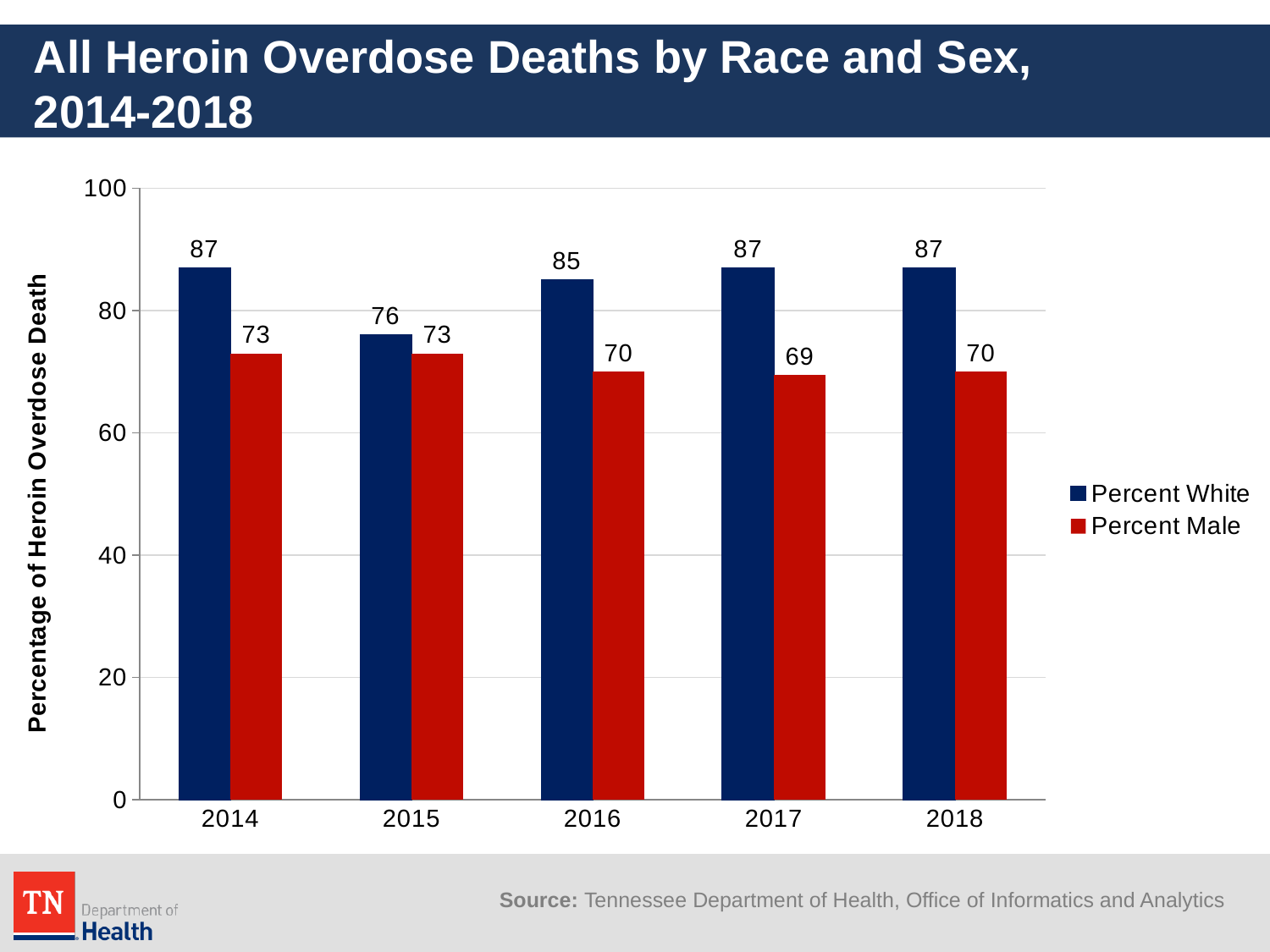
How many series does the legend list? 2 Which year has the lowest Percent Male value? 2017 How many years are shown on the x axis? 5 What is the difference between Percent White in 2015 and Percent White in 2016? 9 Which year has the lowest Percent White value? 2015 What kind of chart is shown on the slide? bar chart What is the difference between Percent White and Percent Male in 2014? 14 What is the Percent White value for 2015? 76 What is the Percent Male value for 2017? 69 Which is larger in 2015, Percent White or Percent Male? Percent White Is the Percent Male value for 2018 greater or less than 80? less What is the Percent White value for 2016? 85